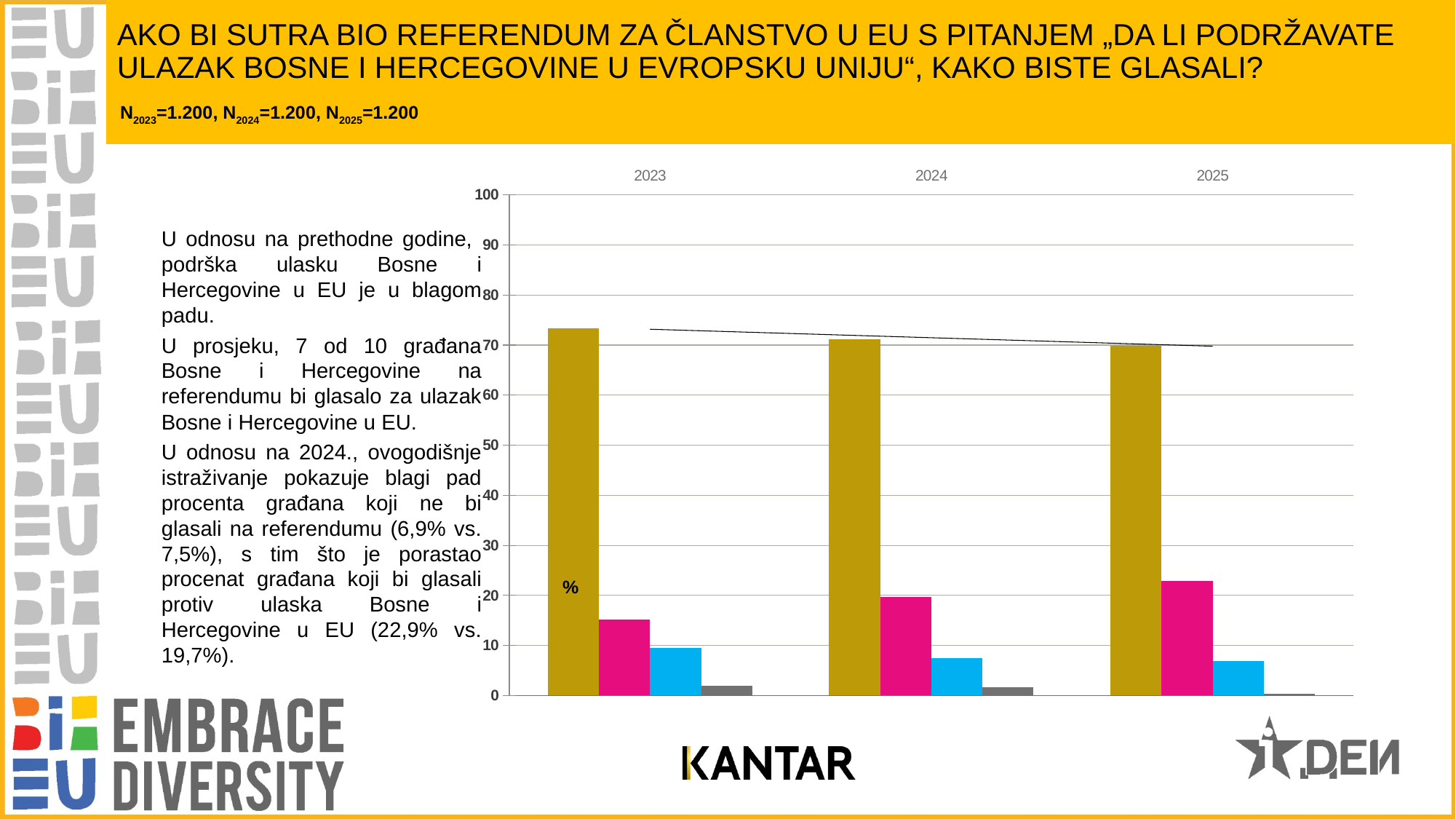
Which year has the smallest grey bar in the chart? 2025 How many bars are plotted for each year in the chart? 4 Which is larger: the blue bar for 2023 or the blue bar for 2025? 2023 Do the pink bars rise or fall from 2023 to 2025? rise Is the value of the grey bar for 2024 greater or less than 10? less Is the value of the pink bar for 2023 greater or less than 20? less How many years (categories) are shown on the x axis of the chart? 3 What kind of chart is shown on the slide? bar chart Which year has the tallest gold bar in the chart? 2023 Is the value of the pink bar for 2025 greater or less than 20? greater Do the gold bars rise or fall from 2023 to 2025? fall